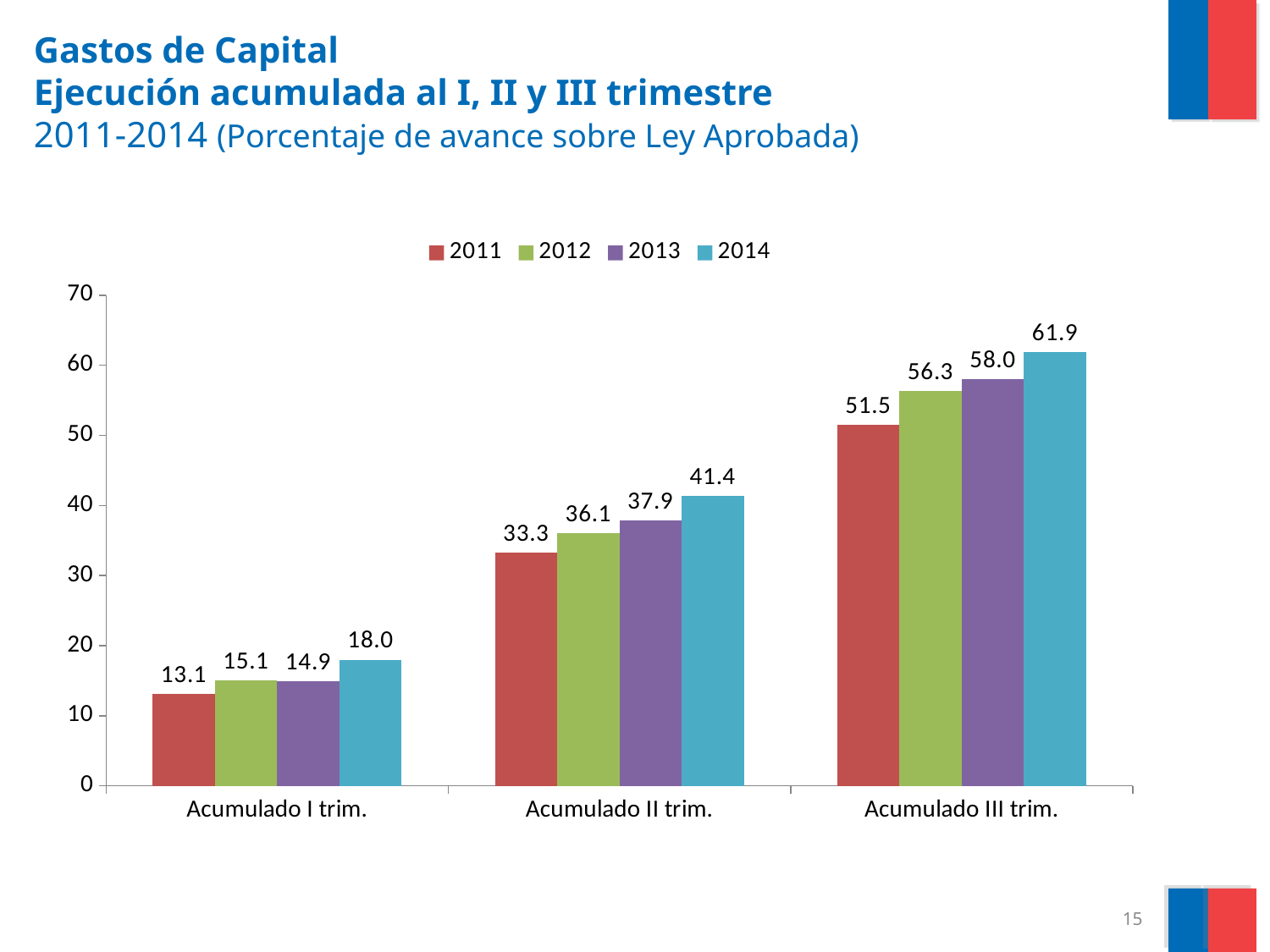
How many series does the legend list? 4 Which is larger in Acumulado I trim., the value for 2012 or the value for 2014? 2014 What is the value for 2014 in Acumulado III trim.? 61.9 Do the values for 2014 rise or fall from Acumulado I trim. to Acumulado III trim.? rise What kind of chart is shown on the slide? bar chart What is the difference between the 2014 and 2011 values in Acumulado II trim.? 8.1 Which year has the highest value in Acumulado III trim.? 2014 Which year has the lowest value in Acumulado I trim.? 2011 Is the value for 2012 in Acumulado III trim. greater or less than 50? greater What is the value for 2011 in Acumulado I trim.? 13.1 What is the value for 2013 in Acumulado II trim.? 37.9 How many categories are shown on the x axis? 3